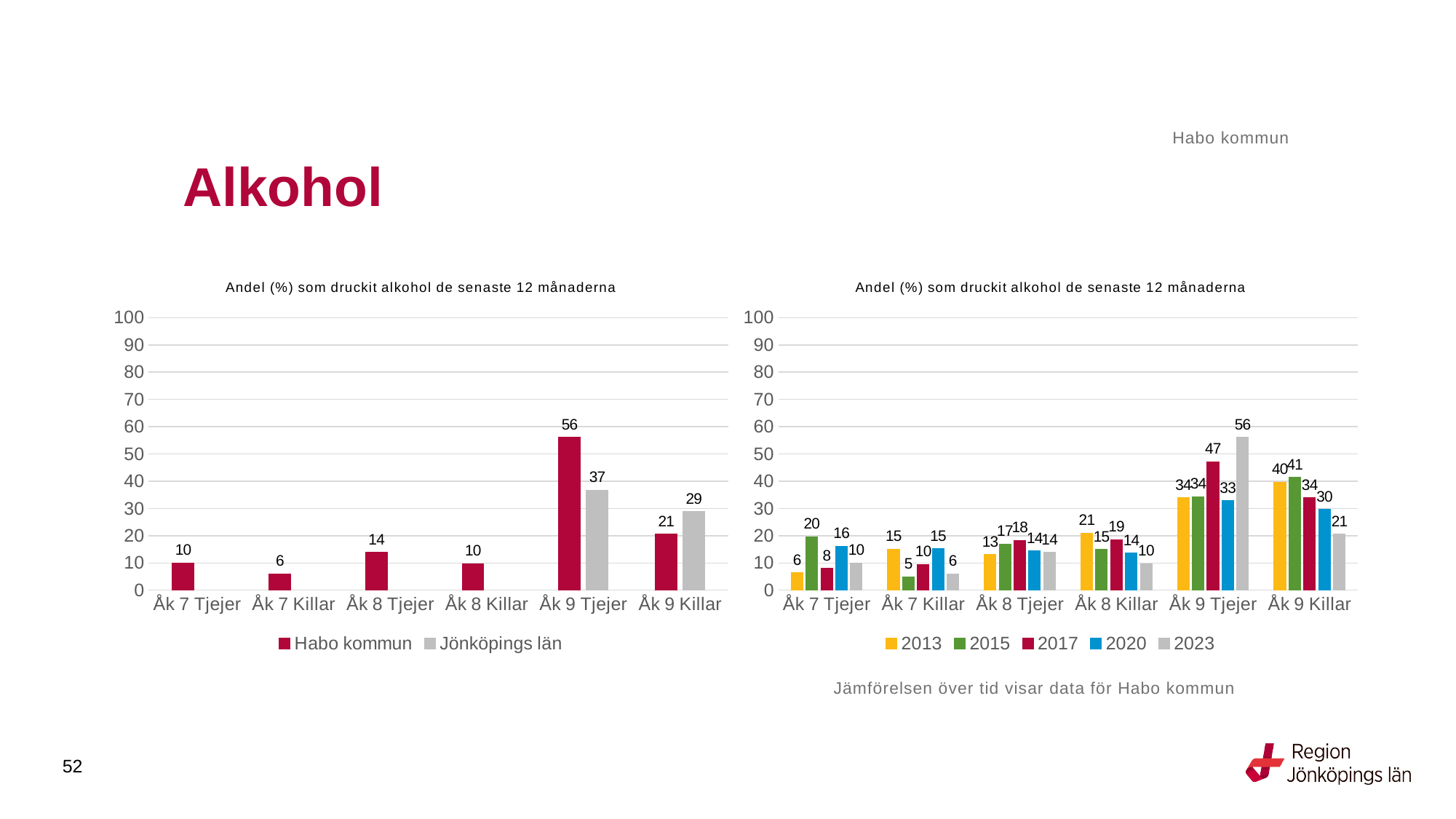
In the right chart, what is the value for 2017 for Åk 9 Tjejer? 47 In the left chart, what is the value for Jönköpings län for Åk 9 Killar? 29 In the left chart, how many series does the legend list? 2 In the left chart, what is the value for Habo kommun for Åk 9 Tjejer? 56 In the right chart, what is the value for 2013 for Åk 8 Killar? 21 In the right chart, what is the difference between the 2015 and 2023 values for Åk 7 Tjejer? 10 In the right chart, which year has the highest value for Åk 9 Tjejer? 2023 What kind of chart is the right chart? Bar chart In the right chart, which is larger for Åk 9 Killar: the value for 2013 or the value for 2023? 2013 In the left chart, which category has the lowest value for Habo kommun? Åk 7 Killar In the right chart, how many series does the legend list? 5 In the left chart, what is the difference between Habo kommun and Jönköpings län for Åk 9 Tjejer? 19